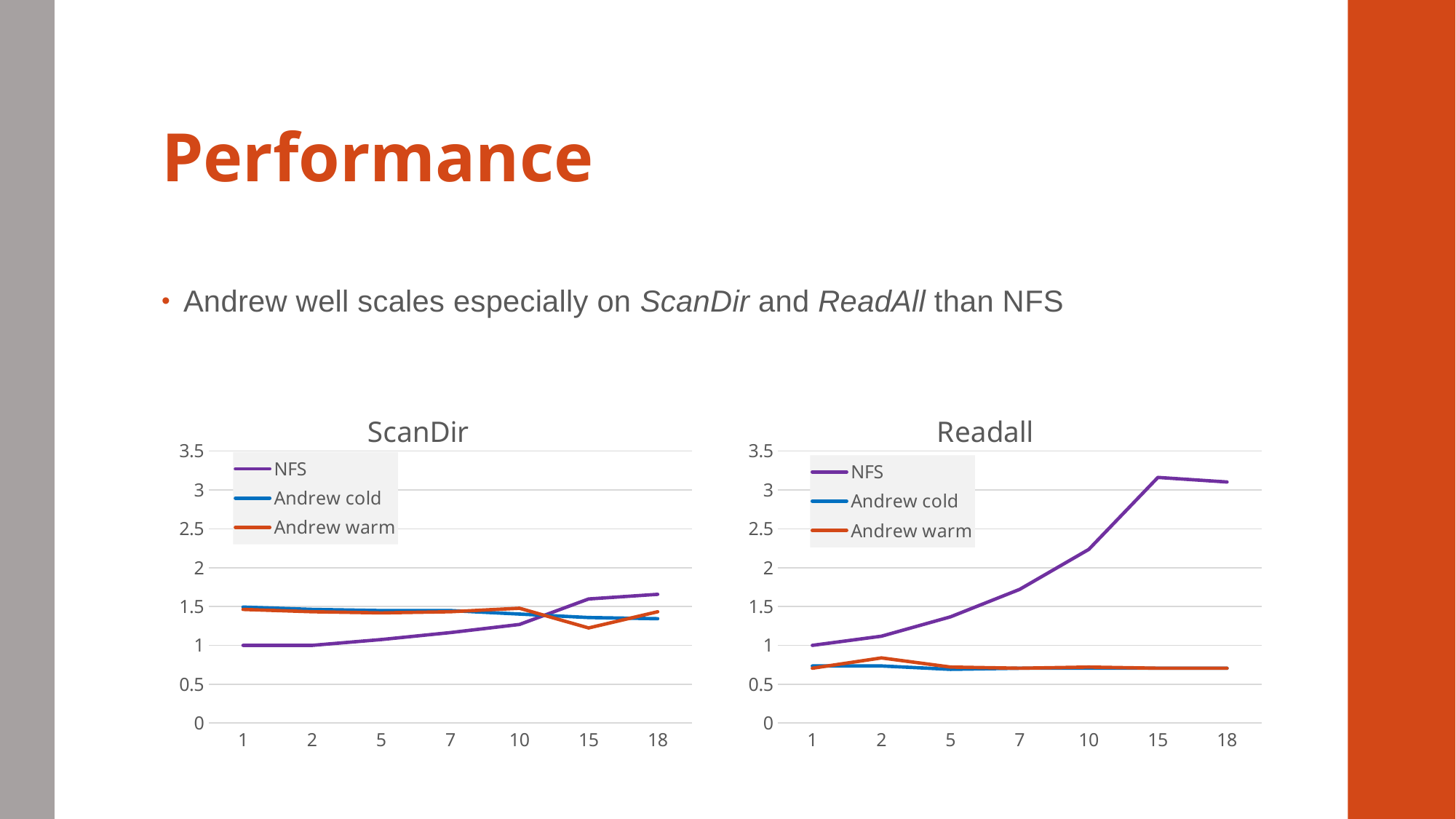
How many series does the legend of the Readall chart list? 3 How many x-axis points are plotted in the ScanDir chart? 7 In the Readall chart, does the NFS line rise or fall as x increases from 1 to 15? rises In the Readall chart, what is the NFS value at x = 1? 1 In the Readall chart, is the Andrew cold value at x = 18 greater or less than 1? less In the ScanDir chart, what is the NFS value at x = 1? 1 In the ScanDir chart, is the NFS value at x = 18 greater or less than 1.5? greater In the Readall chart, is the NFS value at x = 15 greater or less than 3? greater Which series is drawn in purple in both charts? NFS In the Readall chart, which series has the highest value at x = 18? NFS What type of chart is the ScanDir chart? line chart In the ScanDir chart, which series has the lowest value at x = 1? NFS